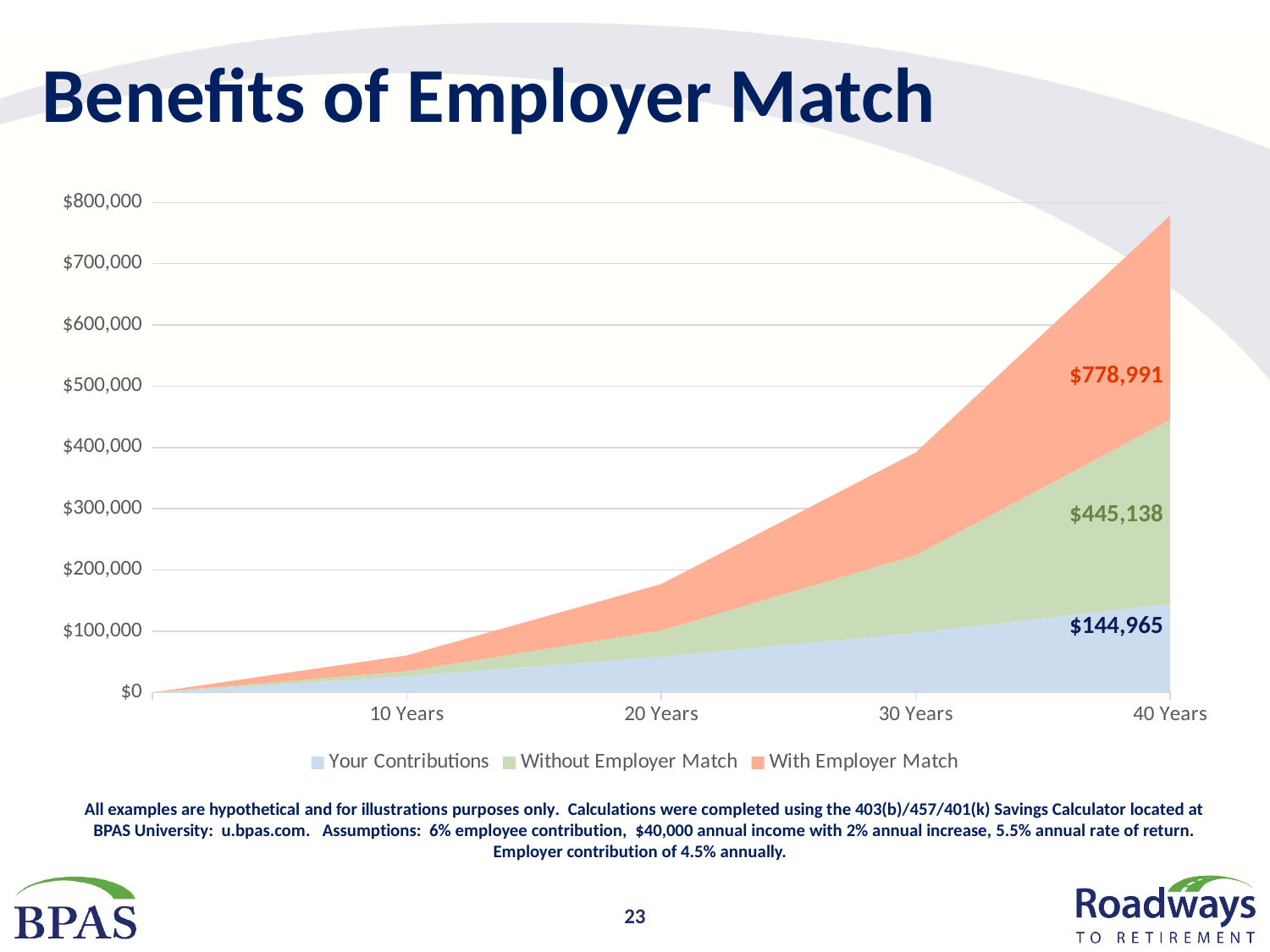
At 40 Years, which is larger: With Employer Match or Without Employer Match? With Employer Match What is the value of Your Contributions at 40 Years? $144,965 What is the value of With Employer Match at 40 Years? $778,991 Do the values for With Employer Match rise or fall as the years increase? Rise At 40 Years, what is the difference between With Employer Match and Without Employer Match? $333,853 What is the title of the chart? Benefits of Employer Match How many series does the legend list? 3 At 40 Years, what is the difference between Without Employer Match and Your Contributions? $300,173 What is the value of Without Employer Match at 40 Years? $445,138 Which series has the highest value at 40 Years? With Employer Match What kind of chart is shown on the slide? Area chart Is the value for With Employer Match at 30 Years greater or less than $300,000? greater